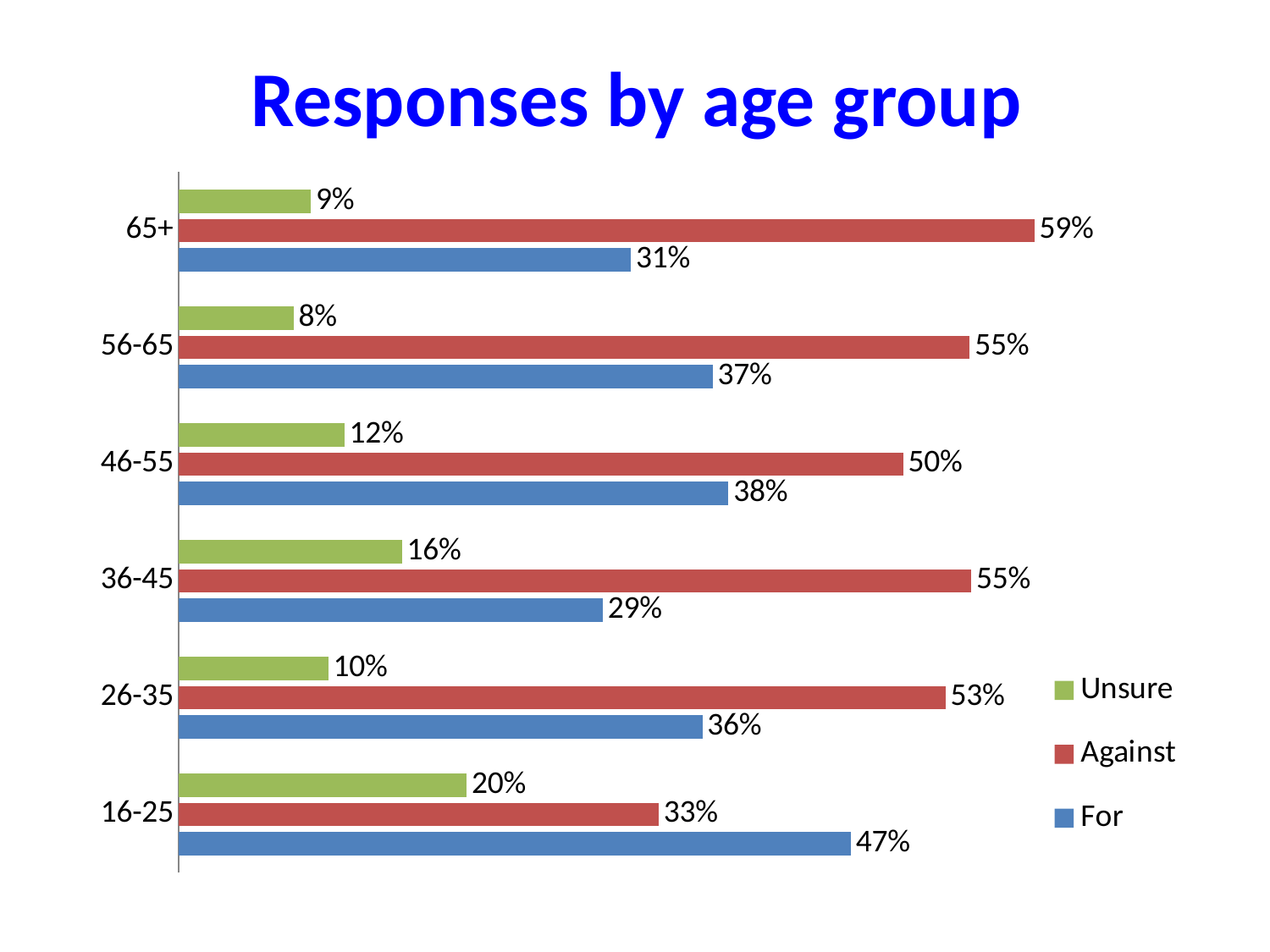
Which age group has the lowest 'Unsure' value? 56-65 How many series does the legend list? 3 What is the difference between the 'Against' and 'For' values for the 26-35 age group? 17% How many age groups are shown on the chart? 6 Which colour represents the 'Unsure' series? Green What is the title of the chart? Responses by age group What is the 'Against' value for the 65+ age group? 59% What kind of chart is shown on the slide? Bar chart Which age group has the highest 'Against' value? 65+ Which is larger for the 46-55 age group, 'For' or 'Against'? Against What is the 'For' value for the 16-25 age group? 47% What is the 'Unsure' value for the 36-45 age group? 16%